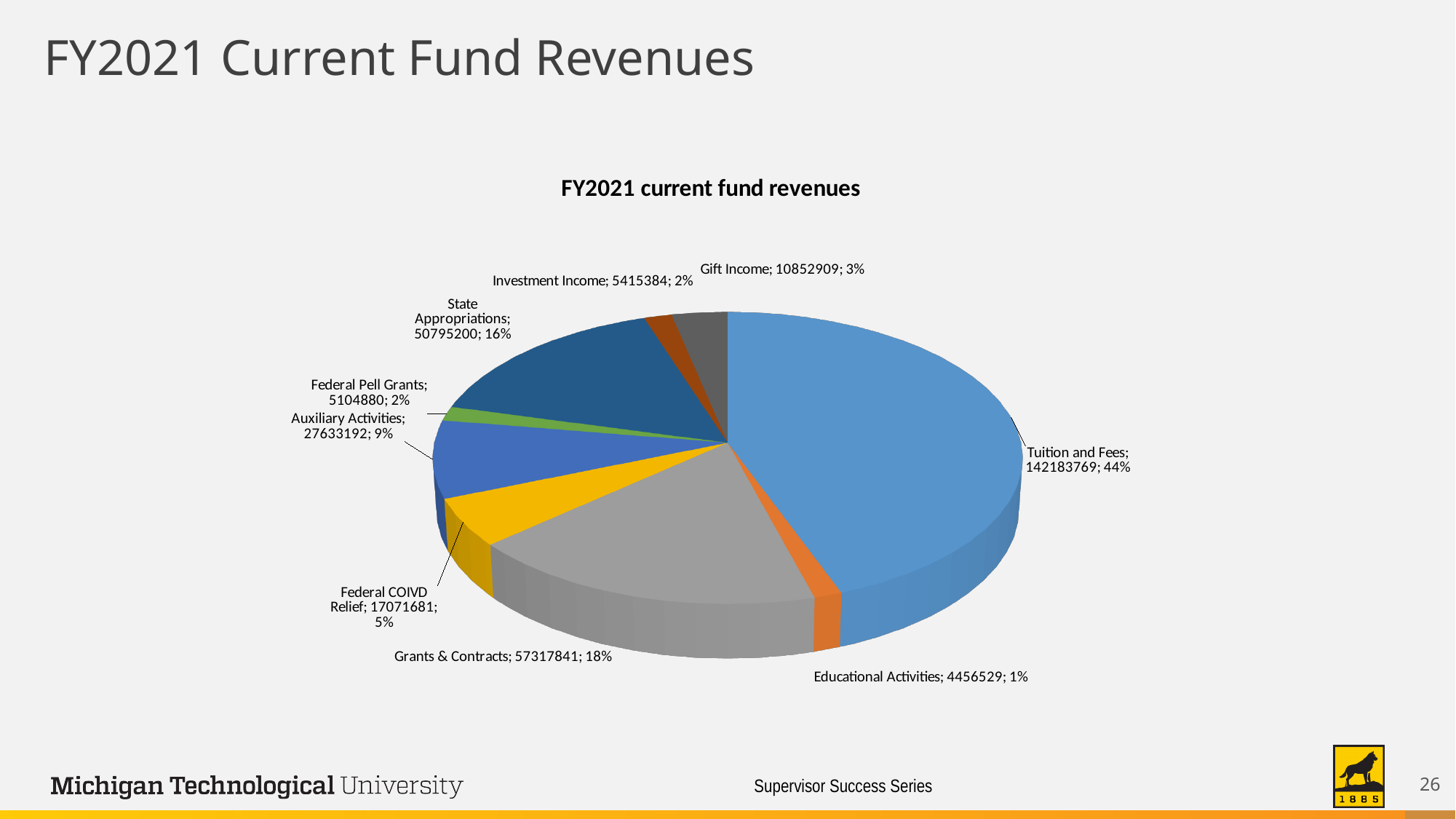
What kind of chart is shown on the slide? Pie chart What share of the pie does Grants & Contracts represent? 18% Which category has the largest slice? Tuition and Fees What is the value for State Appropriations? 50795200 What is the value for Tuition and Fees? 142183769 How many categories (slices) does the pie chart show? 9 What is the value for Federal Pell Grants? 5104880 Which is larger, Grants & Contracts or State Appropriations? Grants & Contracts What is the difference between the values for Federal COIVD Relief and Gift Income? 6218772 What share of the pie does Auxiliary Activities represent? 9% Which category has the smallest slice? Educational Activities What is the title of the chart? FY2021 current fund revenues